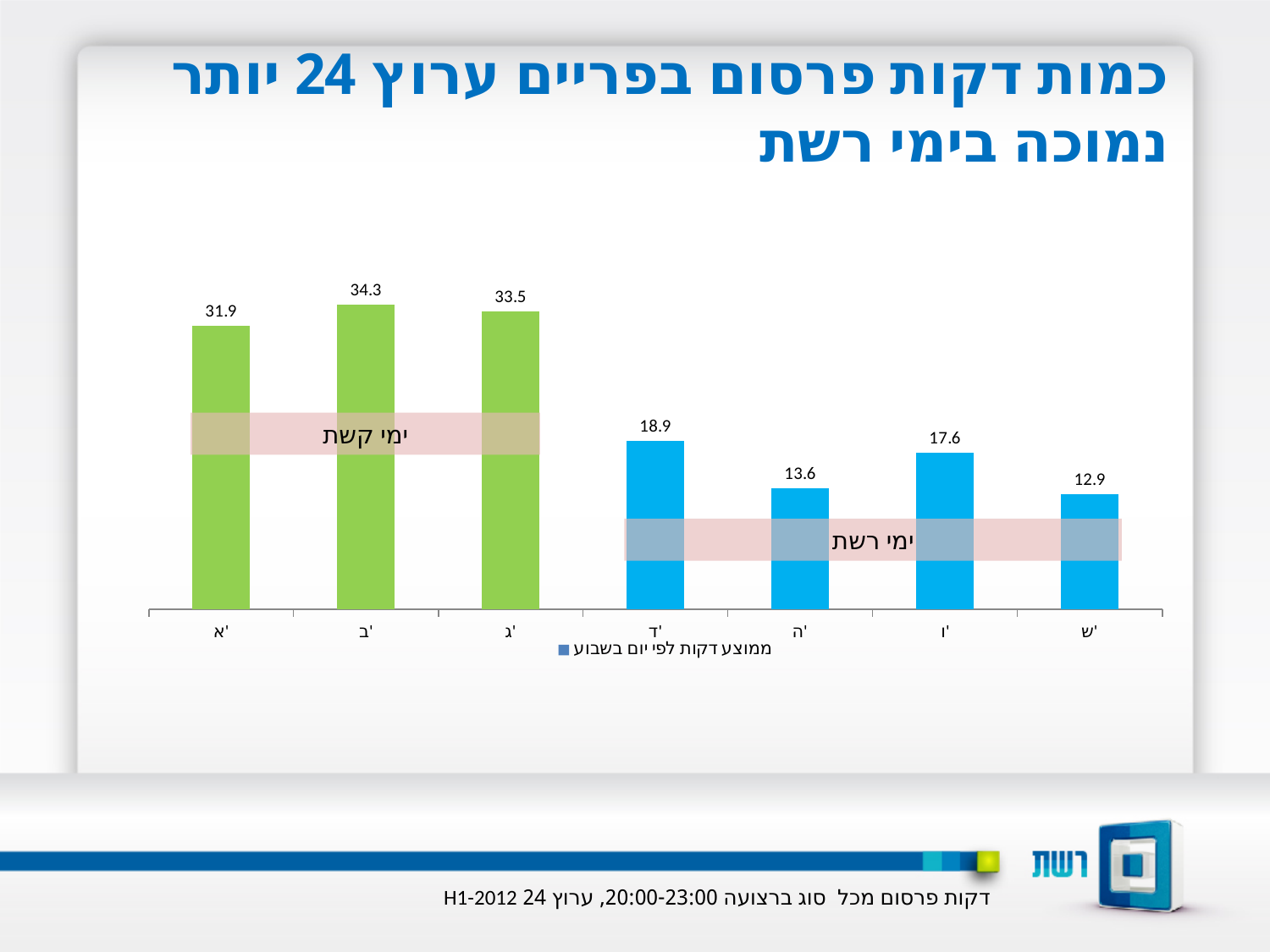
What is the value for day ד' in the chart? 18.9 Which day has the highest value in the chart? ב' What is the difference between the values for ד' and ה'? 5.3 Which is larger, the value for א' or the value for ו'? א' What is the value for day ש' in the chart? 12.9 What is the value for day ב' in the chart? 34.3 What kind of chart is shown on the slide? Bar chart Which day has the lowest value in the chart? ש' How many days (categories) are shown in the chart? 7 What label is shown on the band across the green bars? ימי קשת How many series does the legend list? 1 What is the difference between the values for ב' and ג'? 0.8